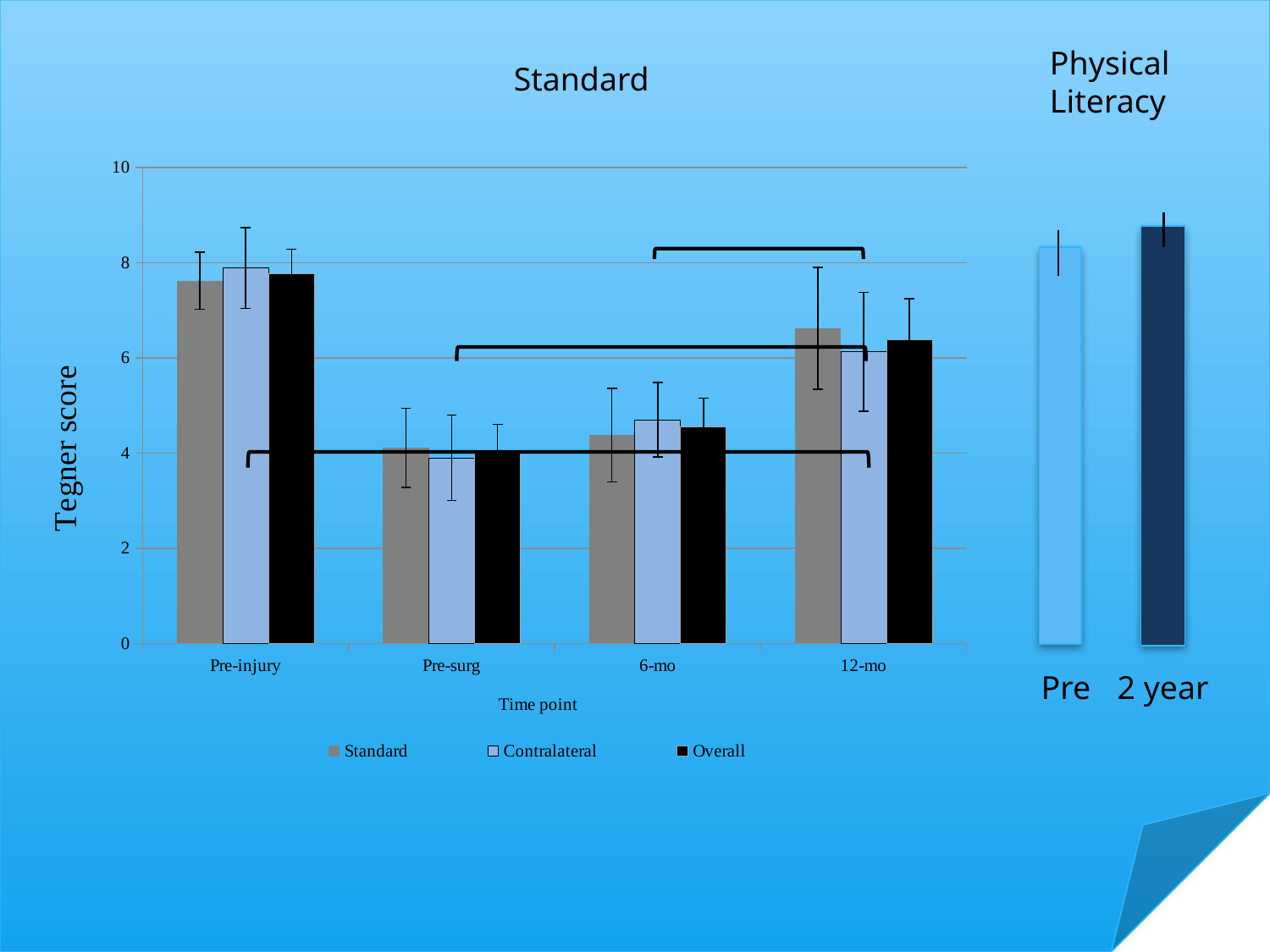
What is the x-axis title of the "Standard" chart? Time point In the "Standard" chart, is the Overall value at 12-mo greater or less than 4? greater How many series does the legend of the "Standard" chart list? 3 In the "Standard" chart, at which time point is the Contralateral series lowest? Pre-surg How many time points are shown on the x axis of the "Standard" chart? 4 What kind of chart is the "Standard" chart on the slide? bar chart In the "Standard" chart, is the Standard value at Pre-injury greater or less than 6? greater In the "Standard" chart, is the Standard value larger at Pre-injury or at 12-mo? Pre-injury In the "Standard" chart, is the Contralateral value at Pre-surg greater or less than 6? less In the "Standard" chart, does the Overall series rise or fall from Pre-injury to Pre-surg? fall In the "Standard" chart, at which time point is the Overall series highest? Pre-injury What is the y-axis title of the "Standard" chart? Tegner score